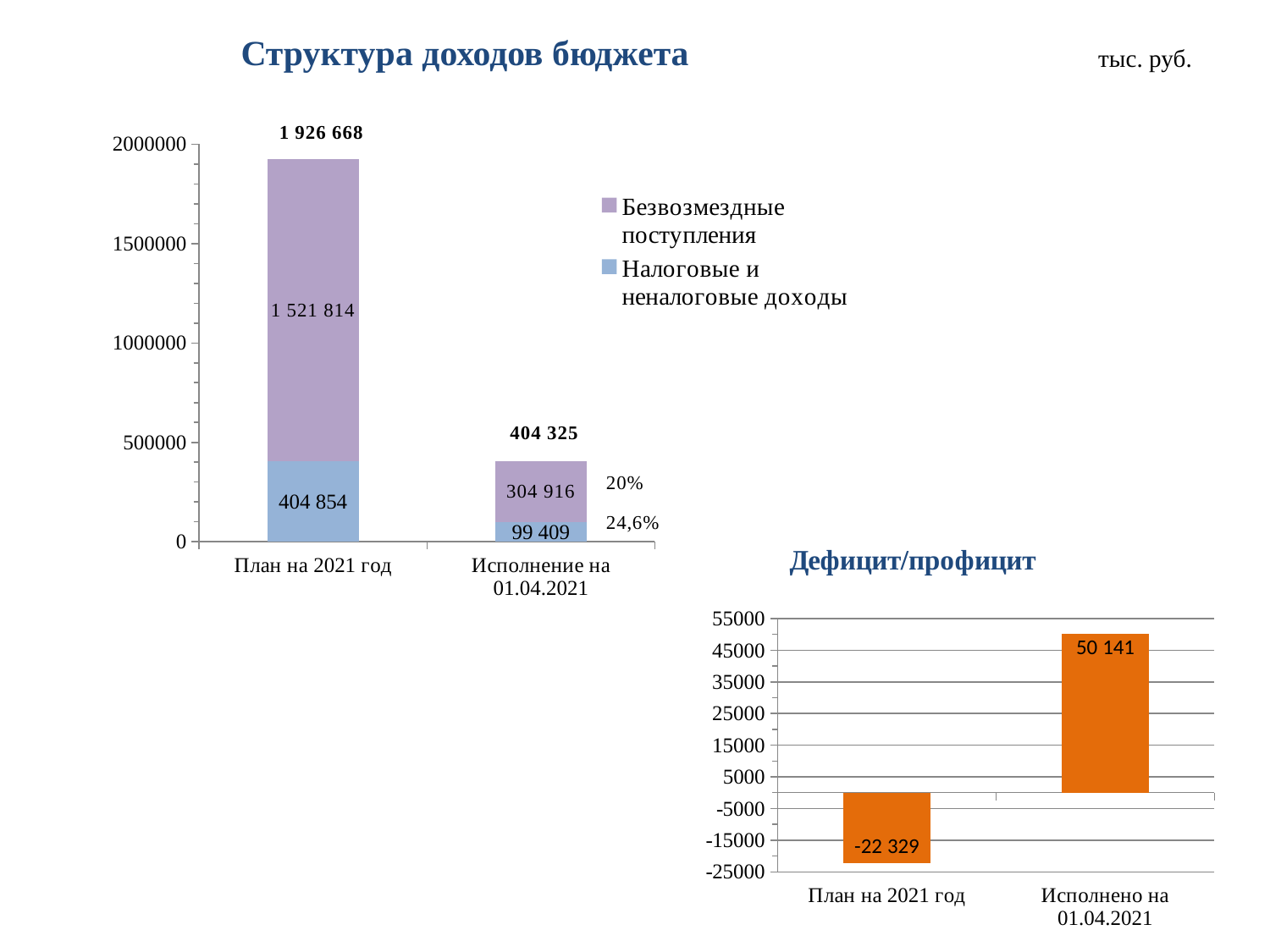
In the 'Дефицит/профицит' chart, what is the value for 'Исполнено на 01.04.2021'? 50 141 What kind of chart is the 'Дефицит/профицит' chart? Bar chart In the 'Структура доходов бюджета' chart, what is the difference between 'Налоговые и неналоговые доходы' for 'План на 2021 год' and for 'Исполнение на 01.04.2021'? 305 445 In the 'Структура доходов бюджета' chart, what is the value of 'Безвозмездные поступления' for 'План на 2021 год'? 1 521 814 In the 'Структура доходов бюджета' chart, what is the value of 'Налоговые и неналоговые доходы' for 'Исполнение на 01.04.2021'? 99 409 In the 'Структура доходов бюджета' chart, which series is shown in purple? Безвозмездные поступления In the 'Структура доходов бюджета' chart, how many series does the legend list? 2 In the 'Структура доходов бюджета' chart, what is the total of the stacked bar for 'План на 2021 год'? 1 926 668 In the 'Дефицит/профицит' chart, what is the value for 'План на 2021 год'? -22 329 In the 'Структура доходов бюджета' chart, what is the total of the stacked bar for 'Исполнение на 01.04.2021'? 404 325 In the 'Дефицит/профицит' chart, which category has the highest value? Исполнено на 01.04.2021 In the 'Дефицит/профицит' chart, how many categories are shown? 2